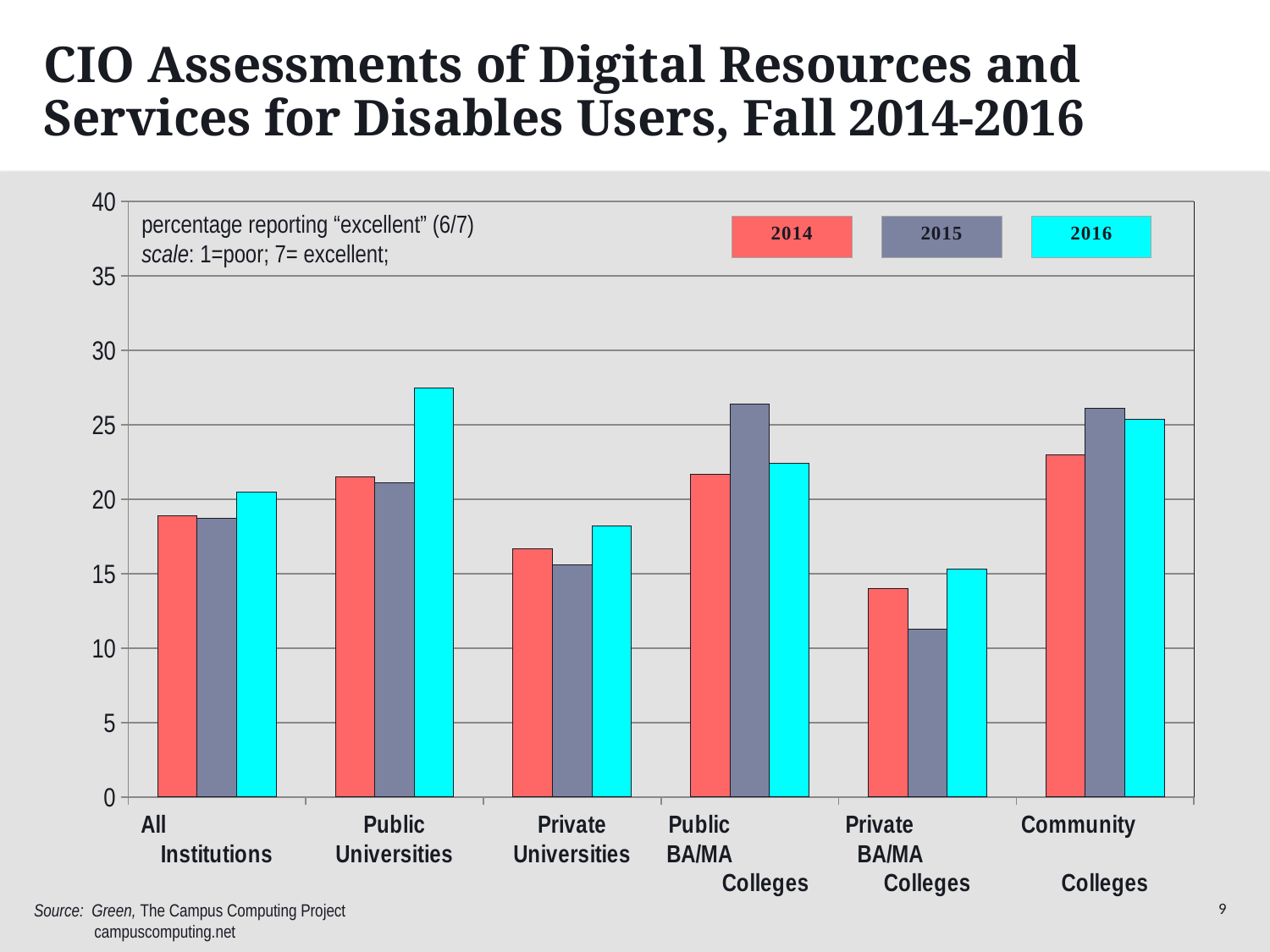
What kind of chart is shown on the slide? bar chart What are the entries in the chart's legend? 2014, 2015, 2016 Which has the larger 2014 value, Community Colleges or Private Universities? Community Colleges Is the 2014 value for Community Colleges greater or less than 20? greater Which category has the highest 2016 value? Public Universities For Public BA/MA Colleges, which year has the larger value, 2014 or 2015? 2015 Which category has the lowest 2014 value? Private BA/MA Colleges How many institution categories are shown along the x axis? 6 Which category has the lowest 2015 value? Private BA/MA Colleges Is the 2015 value for Private BA/MA Colleges greater or less than 15? less Is the 2016 value for Public Universities greater or less than 25? greater How many series does the legend list? 3